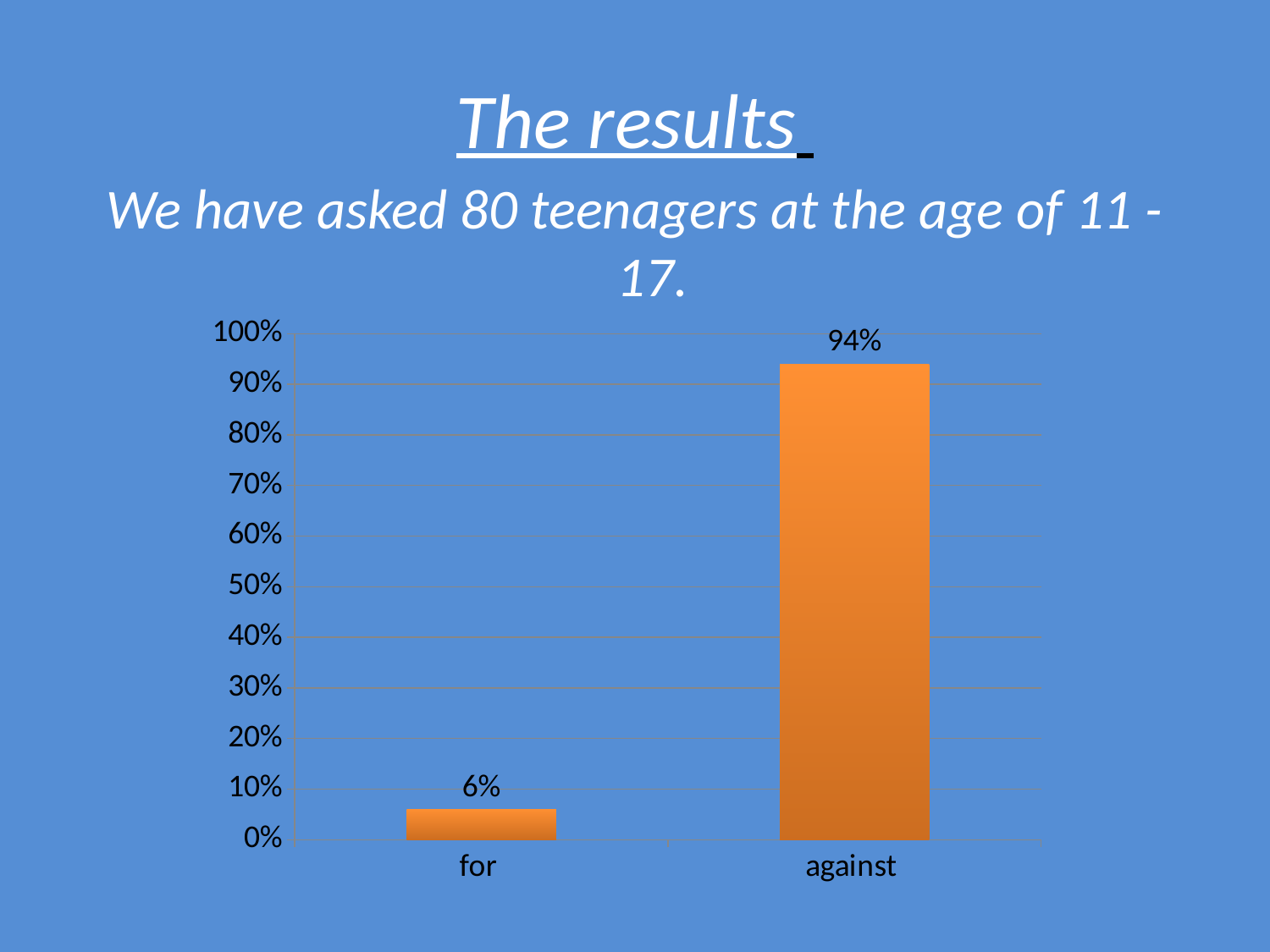
What is the value for "against"? 94% Which category has the highest value? against What is the difference between the values for "against" and "for"? 88% Which is larger, the value for "for" or the value for "against"? against What is the title of the slide? The results Is the value for "for" greater or less than 10%? less What is the value for "for"? 6% How many categories are shown on the chart? 2 What kind of chart is shown on the slide? bar chart Which category has the lowest value? for What is the total of the two values shown on the chart? 100% Is the value for "against" greater or less than 90%? greater